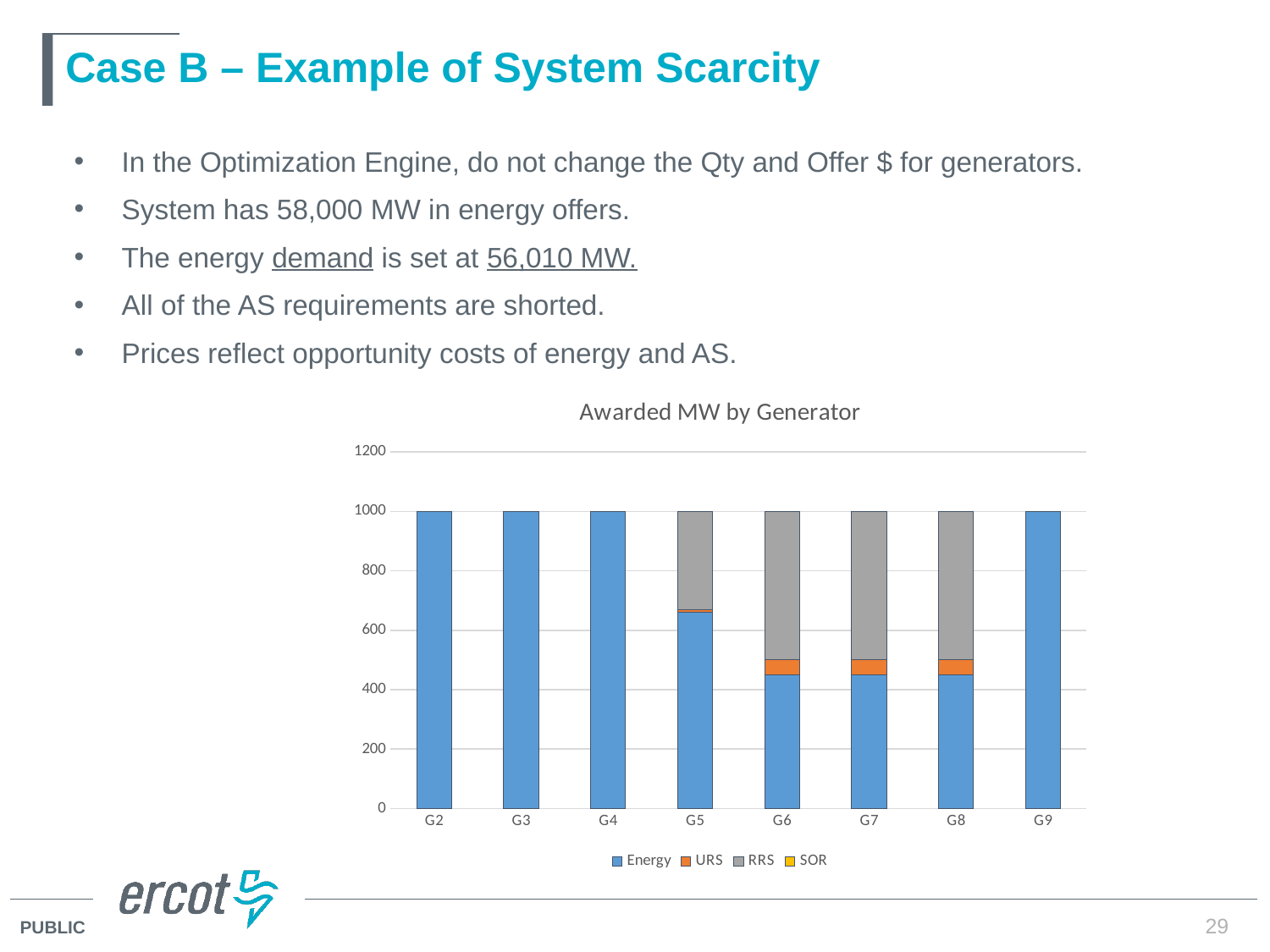
How many generators are shown on the x axis of the chart? 8 Which series are listed in the chart legend? Energy, URS, RRS, SOR What kind of chart is shown on the slide? Stacked bar chart What is the title of the chart? Awarded MW by Generator What is the total awarded MW for generator G6? 1000 What is the Energy value for generator G2? 1000 How many series does the chart legend list? 4 Is the Energy value for G6 greater or less than 400? greater How many generators have an RRS segment in their bar? 4 Which is larger, the Energy value for G3 or the Energy value for G8? G3 Is the Energy value for G5 greater or less than 600? greater Is the Energy value for G7 greater or less than 600? less